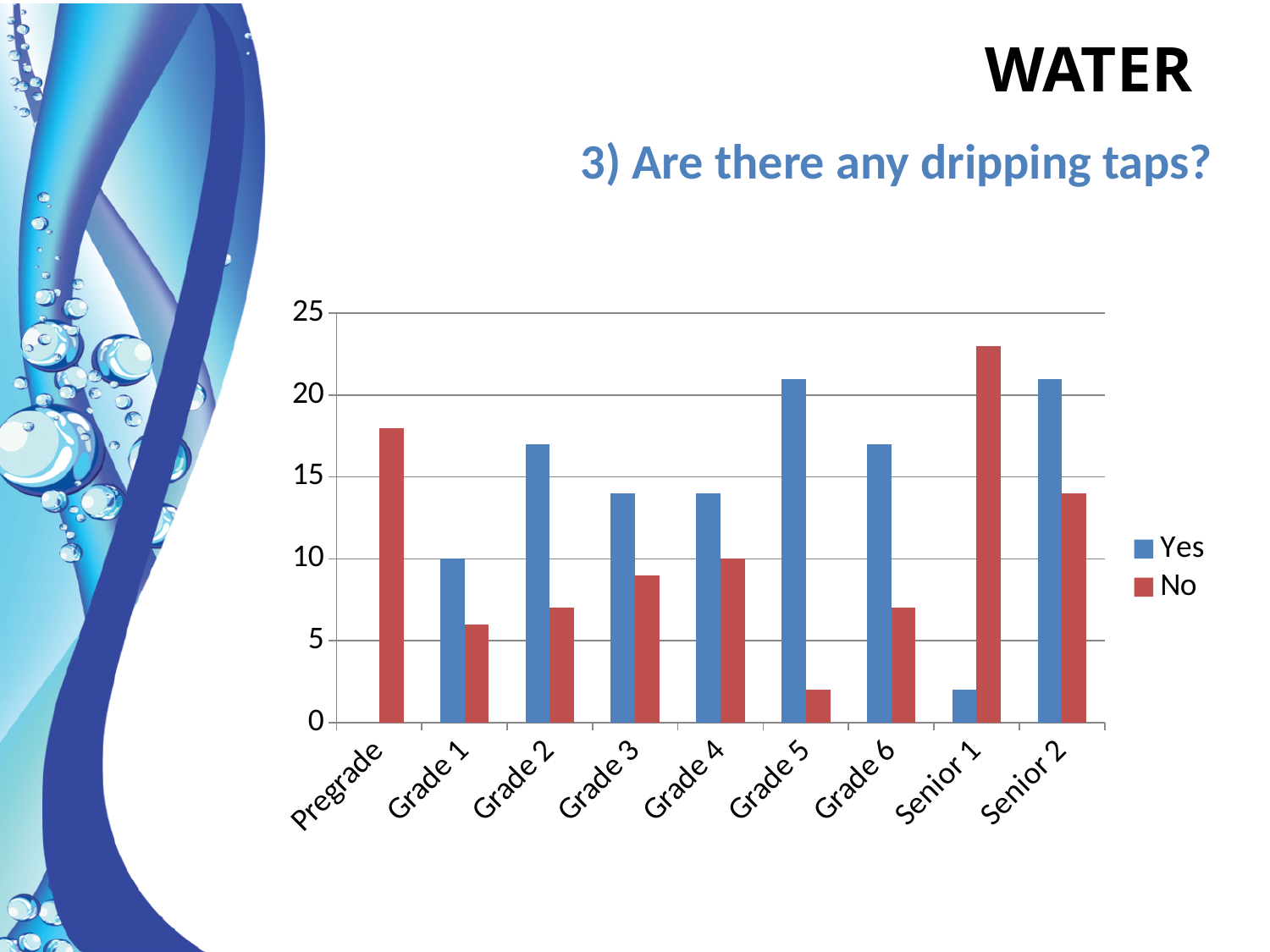
Is the 'No' value for Pregrade greater or less than 15? greater Which colour represents the 'No' series in the chart? red How many grade categories are shown on the x axis? 9 For Grade 2, which is larger, the 'Yes' value or the 'No' value? Yes Is the 'No' value for Senior 1 greater or less than 20? greater Is the 'Yes' value for Senior 1 greater or less than 5? less For Senior 1, which is larger, the 'Yes' value or the 'No' value? No What kind of chart is shown on the slide? bar chart How many series does the legend list? 2 Which category has the lowest 'Yes' value? Pregrade Which category has the highest 'No' value? Senior 1